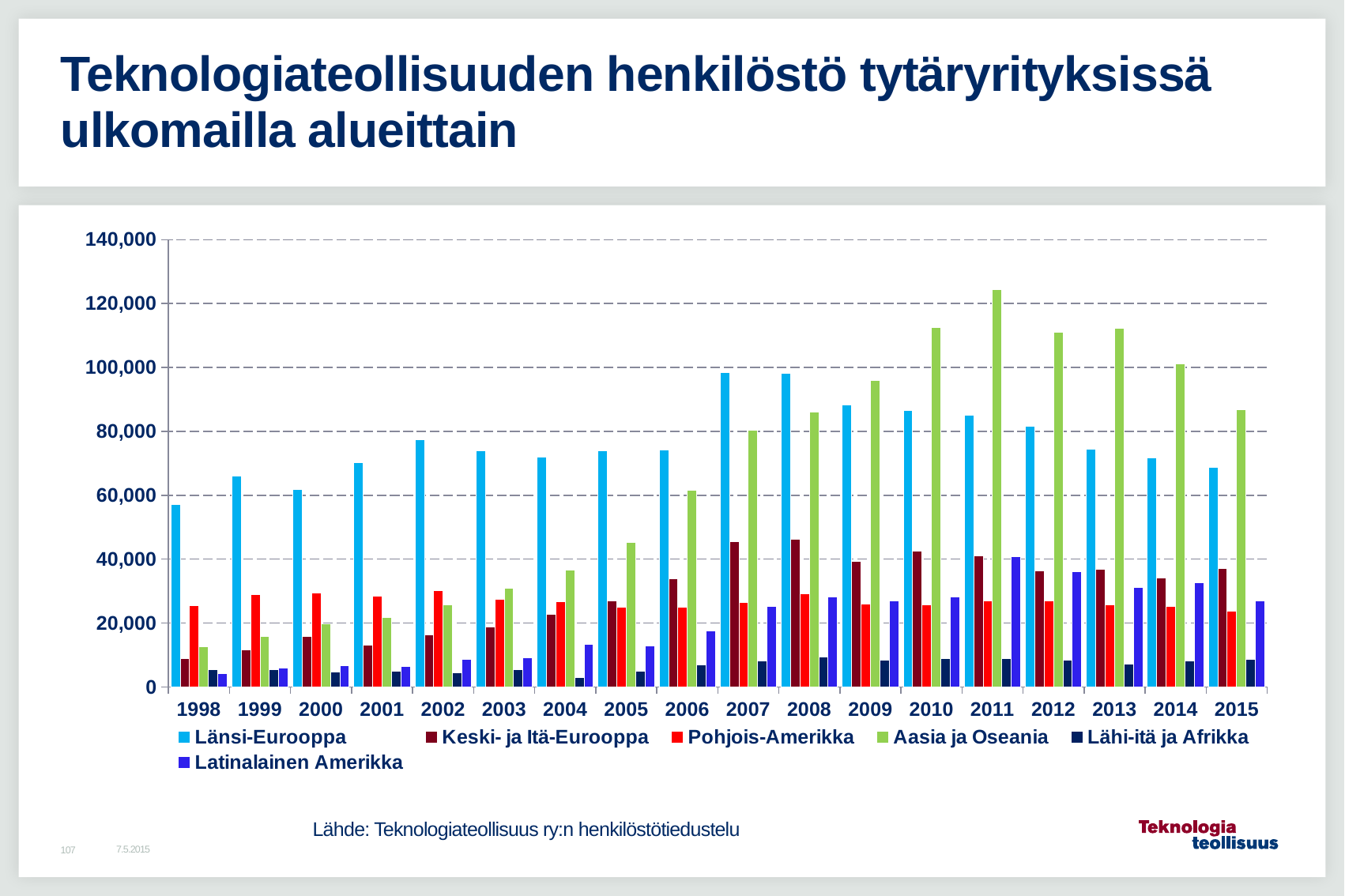
What colour represents Aasia ja Oseania in the legend? green Which series has the highest value in 1998? Länsi-Eurooppa How many series does the legend list? 6 Which series has the lowest value in 2015? Lähi-itä ja Afrikka In 2007, which is larger: Länsi-Eurooppa or Aasia ja Oseania? Länsi-Eurooppa How many years are shown on the x axis? 18 Is the value for Aasia ja Oseania in 2011 greater or less than 120,000? greater What kind of chart is shown on the slide? bar chart Is the value for Länsi-Eurooppa in 1998 greater or less than 60,000? less Does the value for Aasia ja Oseania rise or fall from 1998 to 2011? rise Is the value for Keski- ja Itä-Eurooppa in 2008 greater or less than 40,000? greater In which year is the value for Aasia ja Oseania highest? 2011